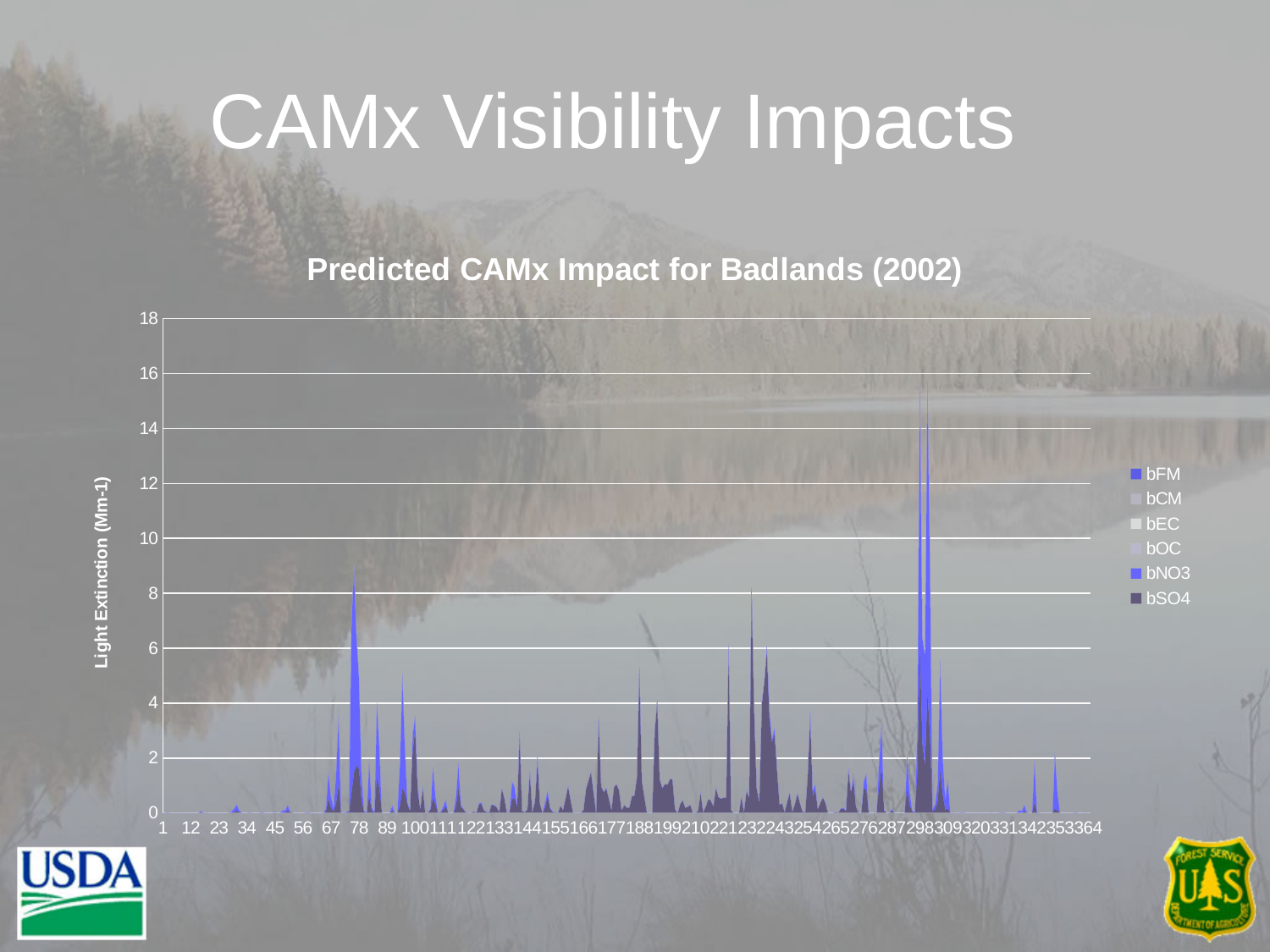
What is the last x-axis tick label shown? 364 Is the peak of the stacked total around day 78 greater or less than 8? greater Is the highest peak of the stacked total (around day 298) greater or less than 14? greater What is the title of the chart? Predicted CAMx Impact for Badlands (2002) Is the peak of the stacked total around day 78 greater or less than 10? less Which is larger, the stacked total peak around day 298 or the peak around day 78? the peak around day 298 What kind of chart is shown on the slide? area chart How many series does the legend list? 6 What is the label of the vertical axis? Light Extinction (Mm-1) What is the maximum value shown on the vertical axis? 18